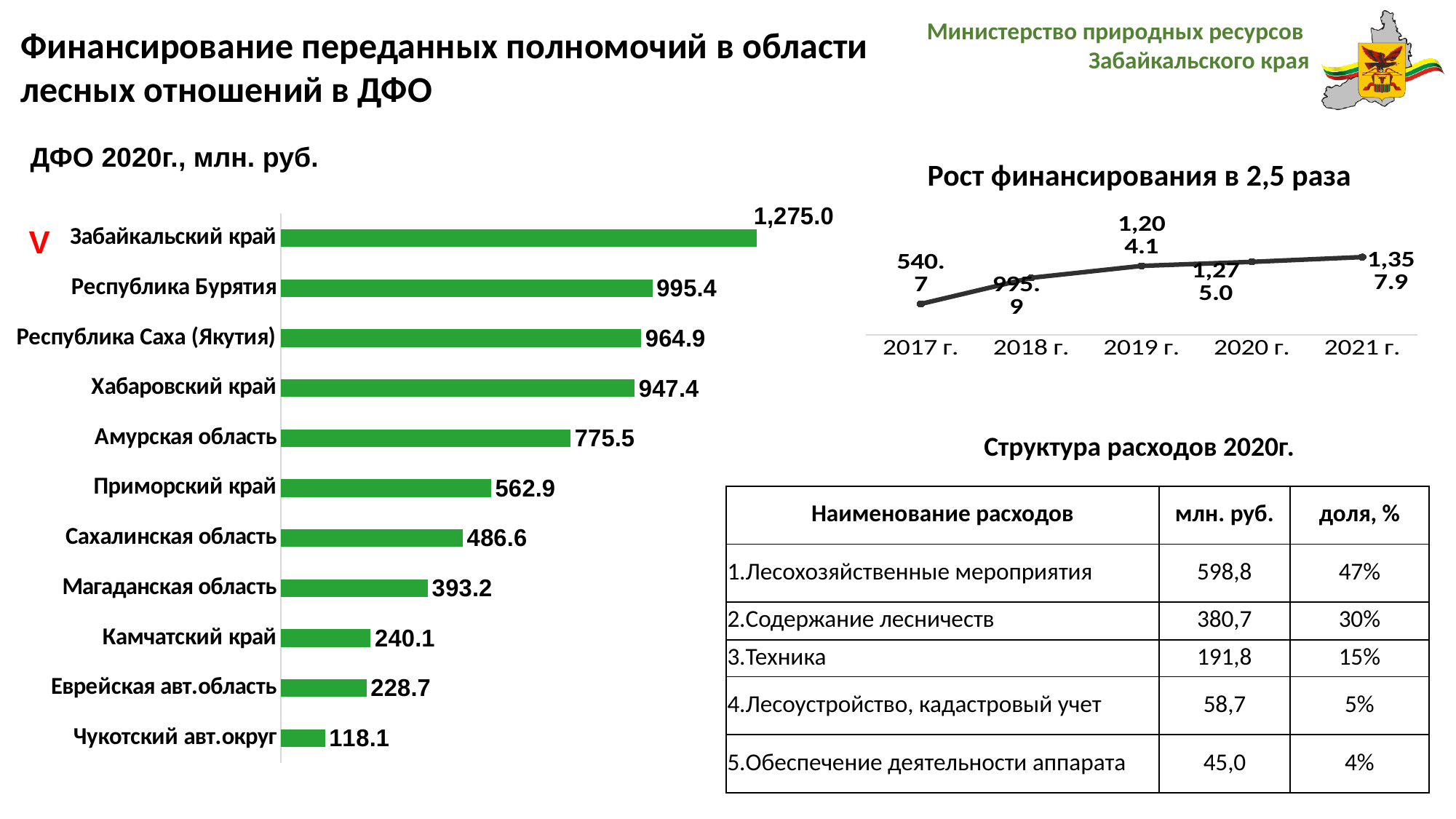
In the bar chart 'ДФО 2020г., млн. руб.', which region has the lowest value? Чукотский авт.округ In the bar chart 'ДФО 2020г., млн. руб.', which is larger: Сахалинская область or Магаданская область? Сахалинская область How many years are plotted in the line chart 'Рост финансирования в 2,5 раза'? 5 In the line chart 'Рост финансирования в 2,5 раза', what is the value for 2017 г.? 540.7 How many regions are shown in the bar chart 'ДФО 2020г., млн. руб.'? 11 In the bar chart 'ДФО 2020г., млн. руб.', what is the difference between Республика Бурятия and Хабаровский край? 48.0 In the bar chart 'ДФО 2020г., млн. руб.', what is the value for Амурская область? 775.5 In the bar chart 'ДФО 2020г., млн. руб.', which region has the highest value? Забайкальский край What kind of chart is 'ДФО 2020г., млн. руб.'? Bar chart In the bar chart 'ДФО 2020г., млн. руб.', what is the value for Чукотский авт.округ? 118.1 In the bar chart 'ДФО 2020г., млн. руб.', what is the value for Забайкальский край? 1,275.0 In the line chart 'Рост финансирования в 2,5 раза', do the values rise or fall from 2017 г. to 2021 г.? Rise